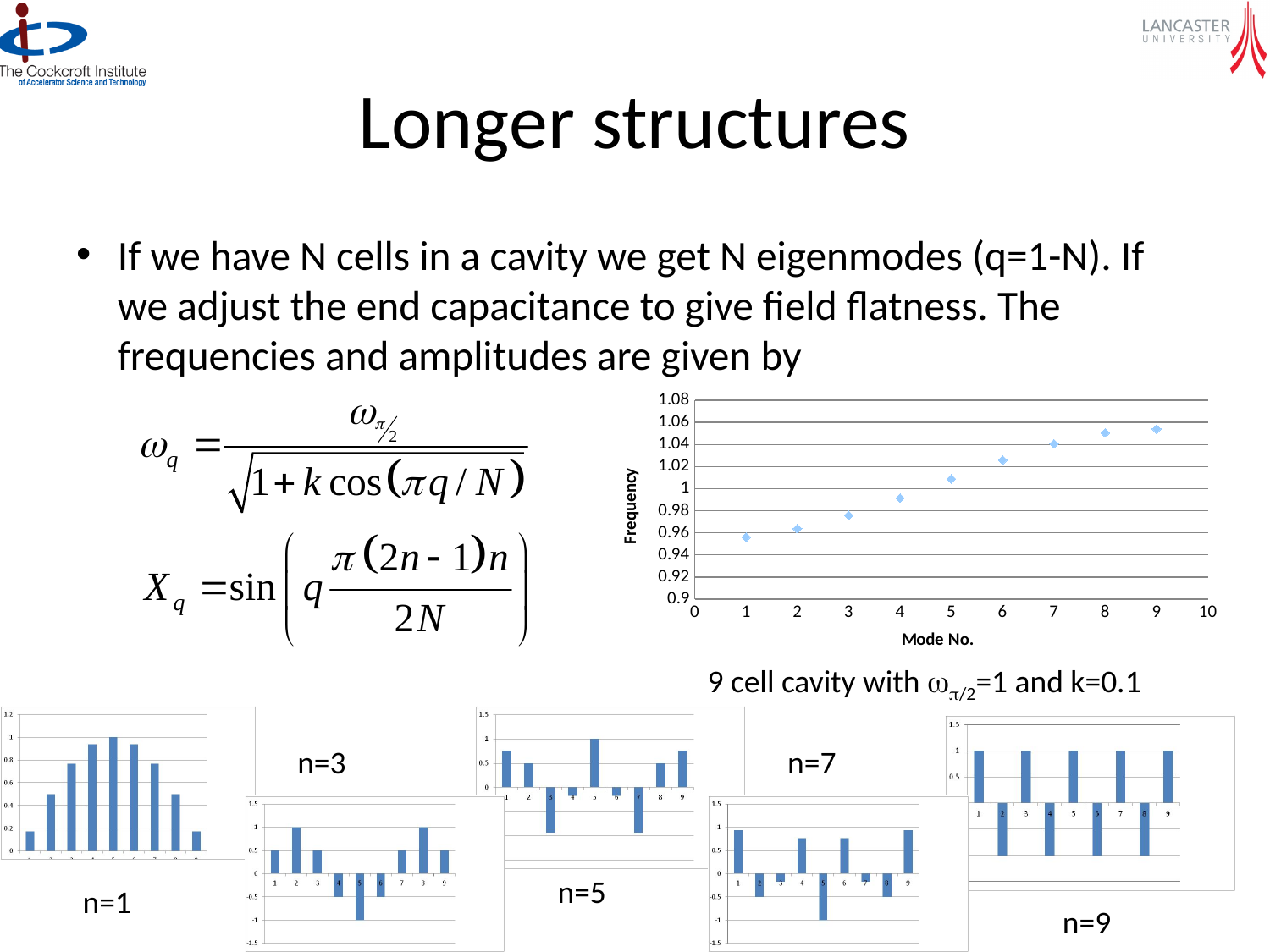
In the Frequency vs Mode No. chart, does the frequency rise or fall as the mode number increases? rise In the Frequency vs Mode No. chart, is the frequency for mode 9 greater or less than 1.04? greater In the n=1 chart at the bottom left, what kind of chart is it? bar chart In the Frequency vs Mode No. chart, which mode number has the lowest frequency? 1 In the Frequency vs Mode No. chart, which mode number has the highest frequency? 9 In the Frequency vs Mode No. chart, how many data points are plotted? 9 In the Frequency vs Mode No. chart, is the frequency for mode 6 greater or less than 1? greater In the Frequency vs Mode No. chart, is the frequency for mode 2 greater or less than 0.98? less In the Frequency vs Mode No. chart, what is the label on the horizontal axis? Mode No. In the n=1 chart at the bottom left, how many bars are there? 9 In the Frequency vs Mode No. chart, which has the larger frequency, mode 8 or mode 2? mode 8 In the Frequency vs Mode No. chart, what kind of chart is it? scatter chart